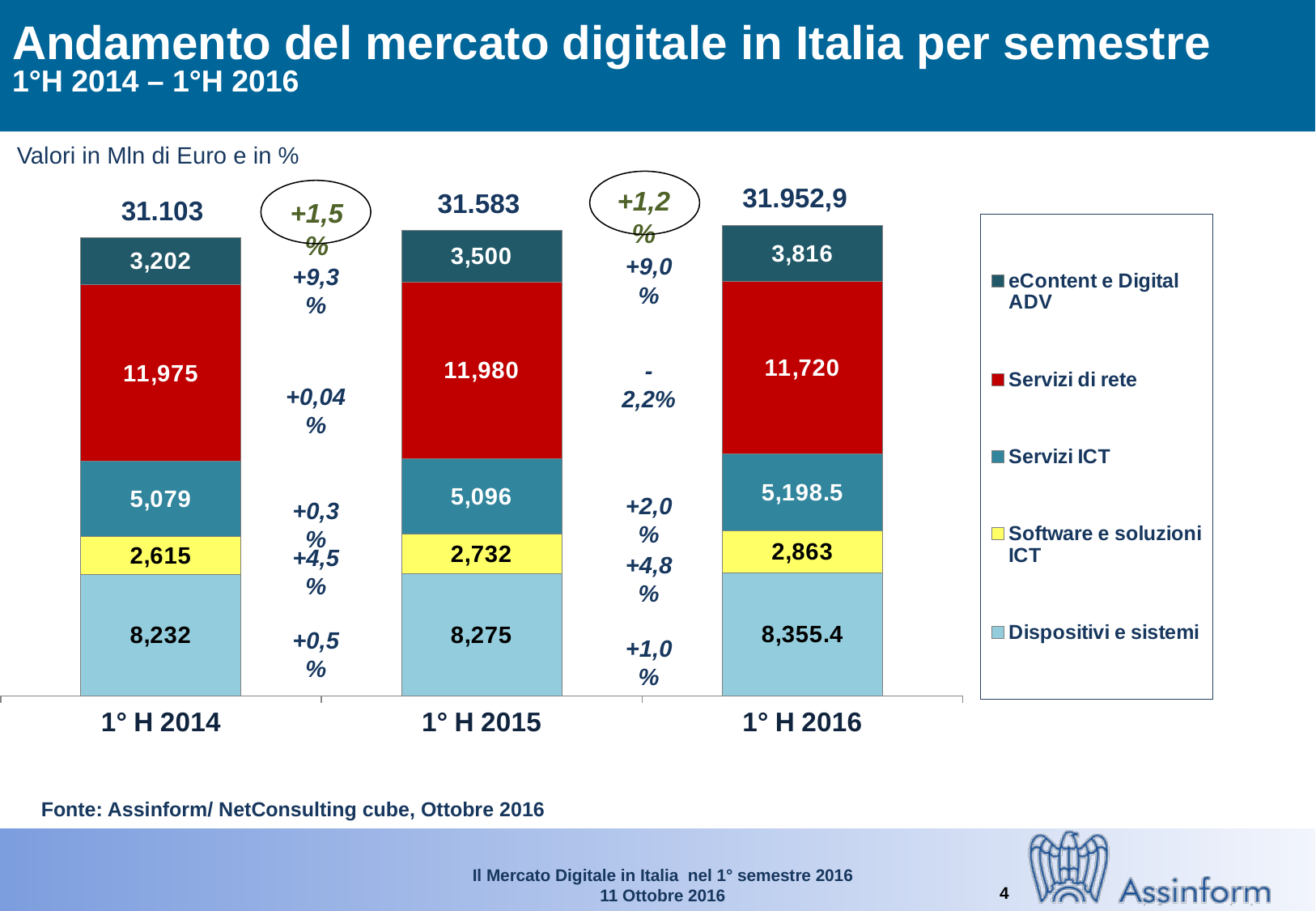
What is the difference between the Servizi ICT values for 1° H 2015 and 1° H 2014? 17 What is the value for Dispositivi e sistemi in 1° H 2016? 8,355.4 How many semesters are shown on the x axis? 3 Is the Servizi di rete value larger in 1° H 2015 or in 1° H 2016? 1° H 2015 What is the total of the stacked bar for 1° H 2014? 31.103 What is the value for eContent e Digital ADV in 1° H 2014? 3,202 What is the total of the stacked bar for 1° H 2016? 31.952,9 How many series does the legend list? 5 What is the value for Servizi di rete in 1° H 2015? 11,980 Which semester has the highest total value? 1° H 2016 What kind of chart is shown on the slide? Stacked bar chart Which series is the smallest segment in the 1° H 2015 bar? Software e soluzioni ICT